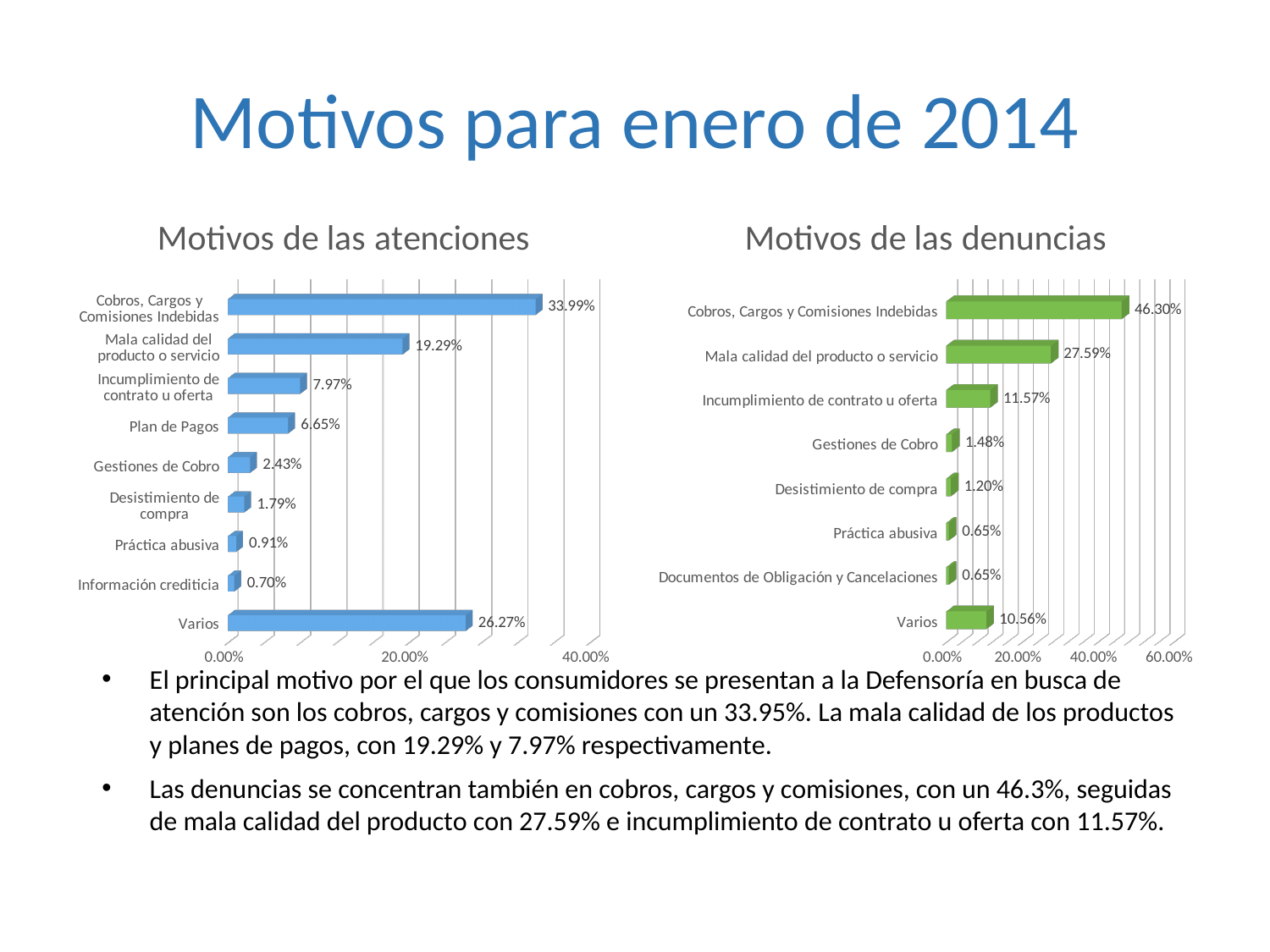
In the 'Motivos de las denuncias' chart, what is the difference between Cobros, Cargos y Comisiones Indebidas and Mala calidad del producto o servicio? 18.71 percentage points In the 'Motivos de las atenciones' chart, what is the difference between Cobros, Cargos y Comisiones Indebidas and Mala calidad del producto o servicio? 14.70 percentage points In the 'Motivos de las denuncias' chart, is the value for Varios greater or less than 20.00%? less In the 'Motivos de las atenciones' chart, which category has the lowest value? Información crediticia In the 'Motivos de las atenciones' chart, what is the value for Varios? 26.27% In the 'Motivos de las denuncias' chart, what is the value for Incumplimiento de contrato u oferta? 11.57% What kind of chart is 'Motivos de las denuncias'? Bar chart In the 'Motivos de las atenciones' chart, what is the value for Cobros, Cargos y Comisiones Indebidas? 33.99% In the 'Motivos de las denuncias' chart, which category has the highest value? Cobros, Cargos y Comisiones Indebidas How many categories are shown in the 'Motivos de las atenciones' chart? 9 In the 'Motivos de las atenciones' chart, which is larger: Plan de Pagos or Gestiones de Cobro? Plan de Pagos How many categories are shown in the 'Motivos de las denuncias' chart? 8